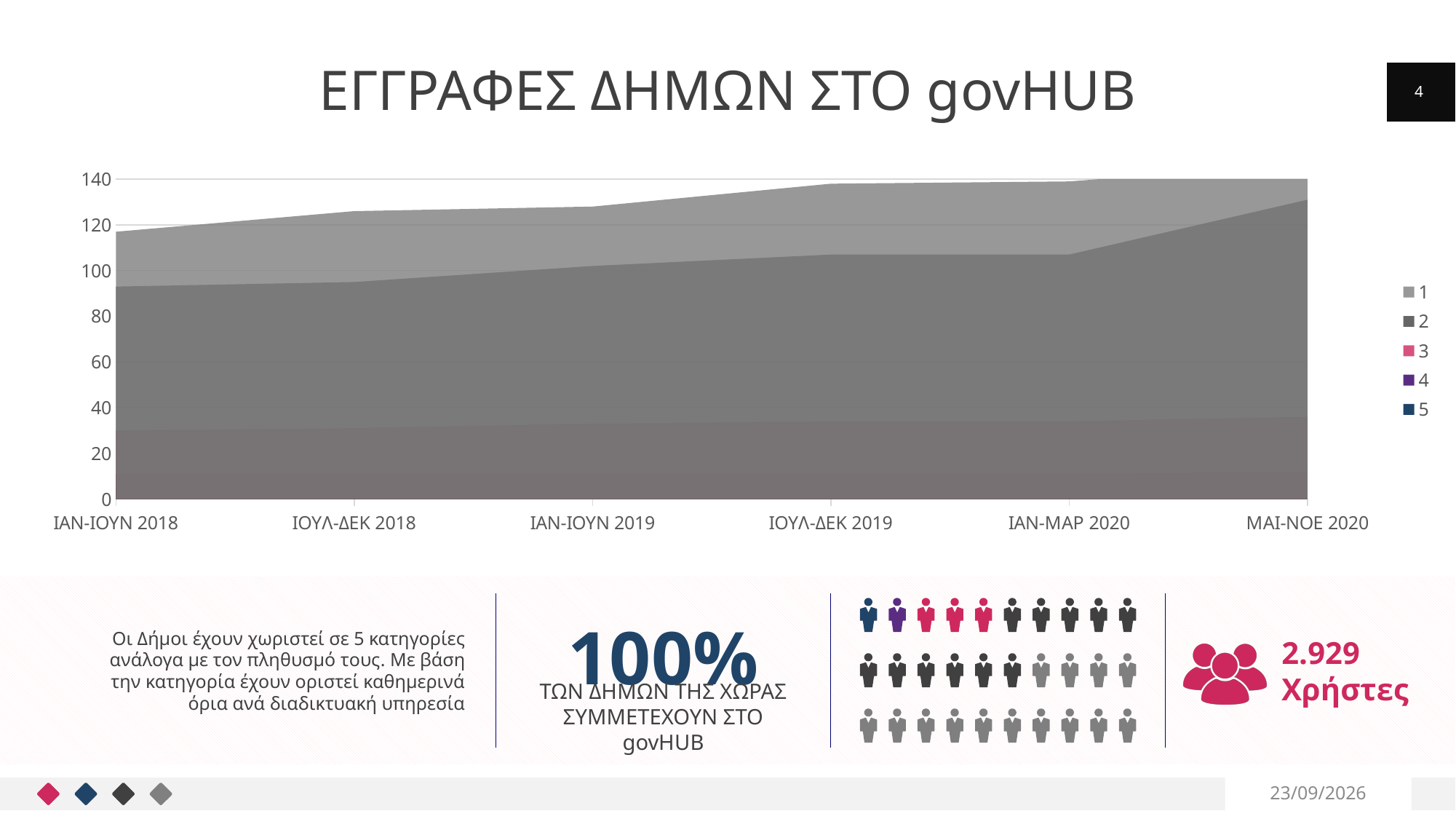
What kind of chart is shown on the slide? Area chart In which period is the total of the stacked areas the lowest? ΙΑΝ-ΙΟΥΝ 2018 How many series does the chart's legend list? 5 Does the total height of the stacked areas rise or fall from ΙΑΝ-ΙΟΥΝ 2018 to ΜΑΙ-ΝΟΕ 2020? Rise What is the first period shown on the x axis of the chart? ΙΑΝ-ΙΟΥΝ 2018 Is the total of the stacked areas at ΙΟΥΛ-ΔΕΚ 2019 greater or less than 120? greater Which period has the larger total of the stacked areas, ΙΑΝ-ΙΟΥΝ 2018 or ΜΑΙ-ΝΟΕ 2020? ΜΑΙ-ΝΟΕ 2020 How many time periods are shown along the x axis of the chart? 6 What is the title of the chart on the slide? ΕΓΓΡΑΦΕΣ ΔΗΜΩΝ ΣΤΟ govHUB Is the total of the stacked areas at ΙΑΝ-ΙΟΥΝ 2019 greater or less than 100? greater What is the highest value shown on the chart's y axis? 140